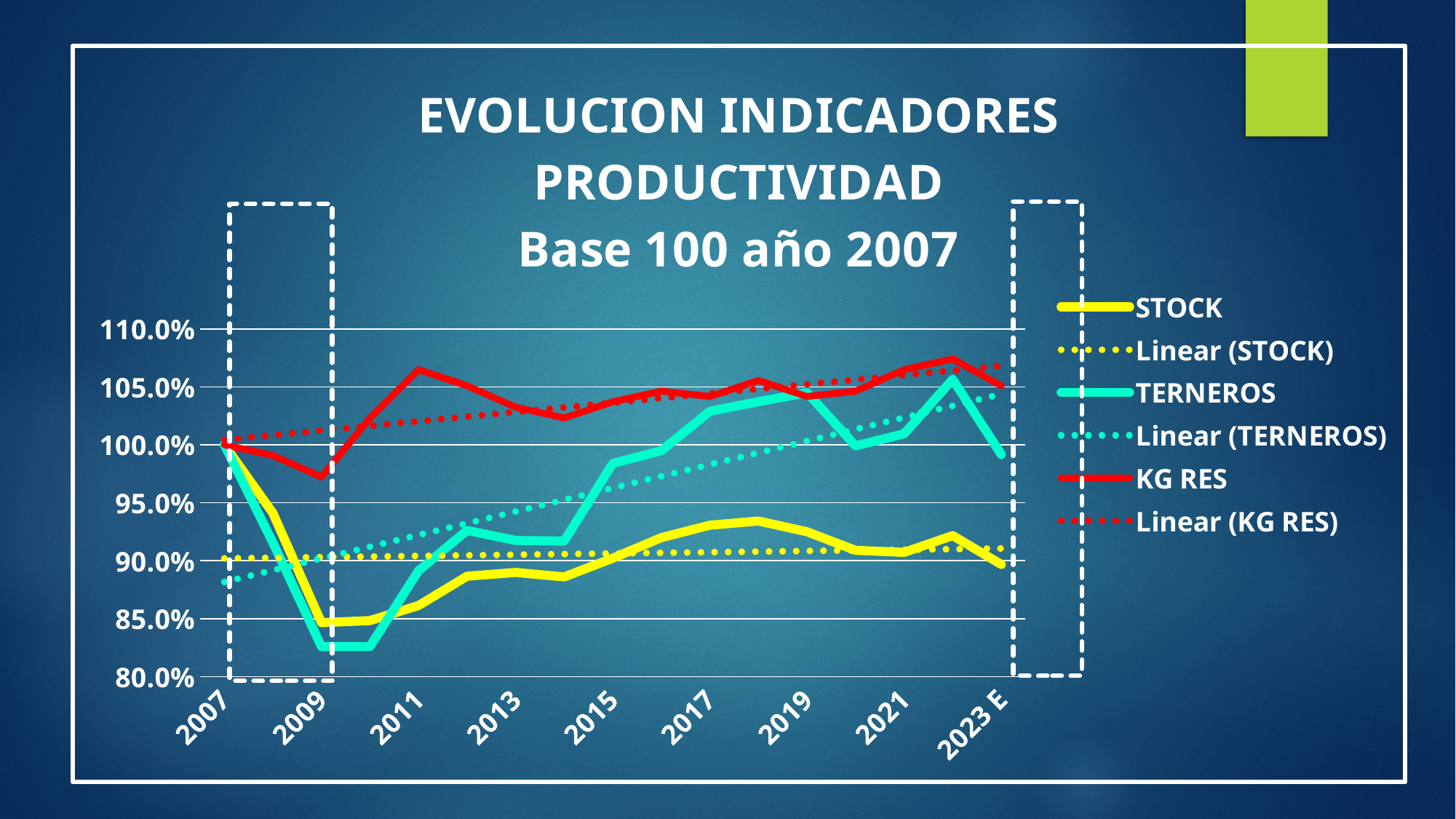
What is the value of STOCK in 2007? 100.0% What is the title of the chart? EVOLUCION INDICADORES PRODUCTIVIDAD Base 100 año 2007 Is the value for STOCK in 2009 greater or less than 90.0%? less Is the value for TERNEROS in 2009 greater or less than 85.0%? less Which series has the lowest value in 2023 E? STOCK Which series has the highest value in 2023 E? KG RES Is the value for KG RES in 2011 greater or less than 105.0%? greater What kind of chart is shown on the slide? line chart How many entries does the chart legend list? 6 In 2009, which series has the higher value, STOCK or TERNEROS? STOCK Does the KG RES series overall rise or fall from 2007 to 2023 E? rise